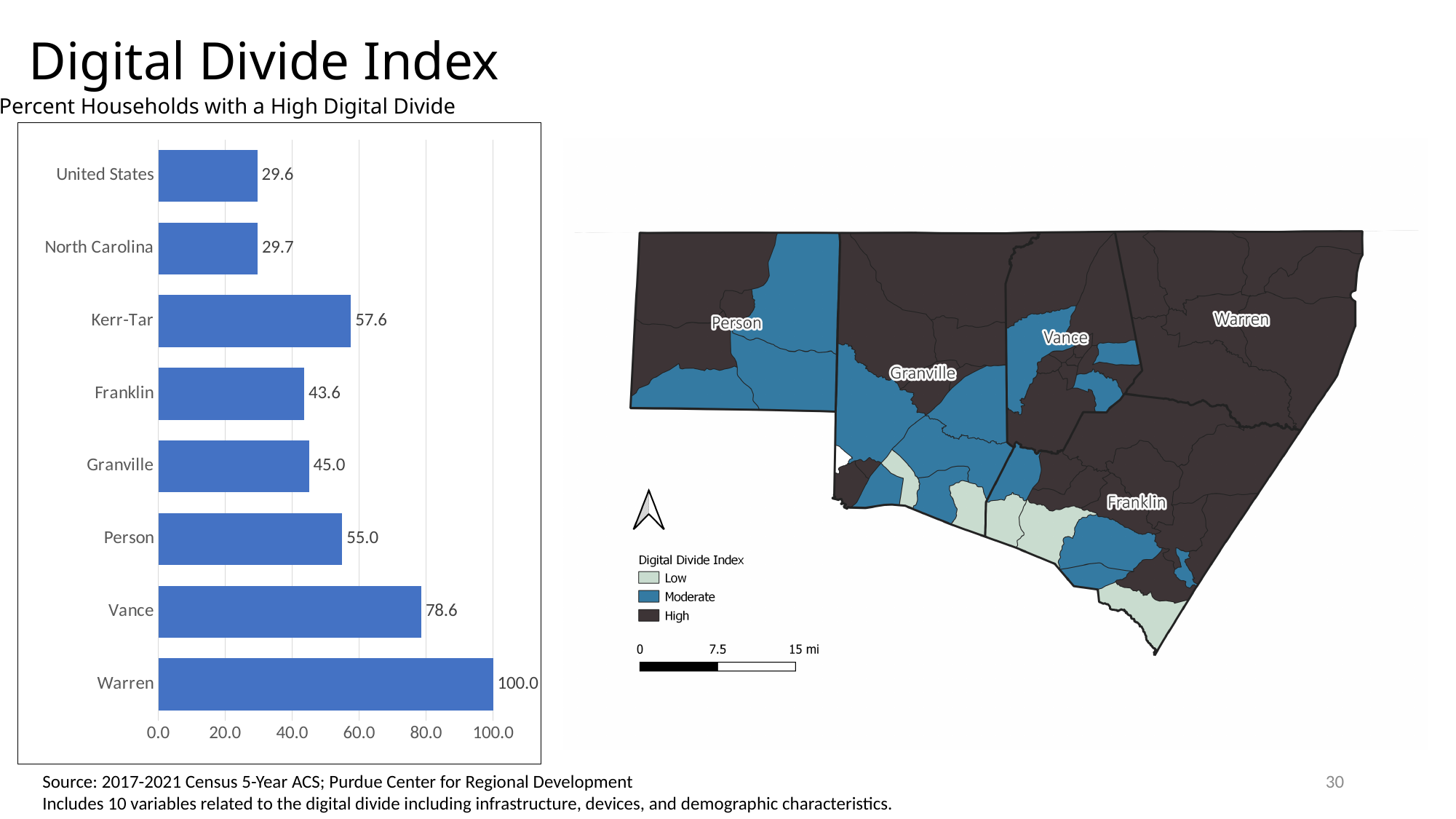
What is the value for Warren in the bar chart? 100.0 Which category has the lowest value in the bar chart? United States How many categories are shown in the bar chart? 8 What is the value for North Carolina in the bar chart? 29.7 What is the difference between the values for Warren and Vance in the bar chart? 21.4 Which has a larger value in the bar chart, Franklin or Person? Person Which category has the highest value in the bar chart? Warren What is the value for Kerr-Tar in the bar chart? 57.6 What is the title of the bar chart? Percent Households with a High Digital Divide What kind of chart is shown on the left of the slide? Bar chart What is the value for Vance in the bar chart? 78.6 What is the difference between the values for Person and Granville in the bar chart? 10.0